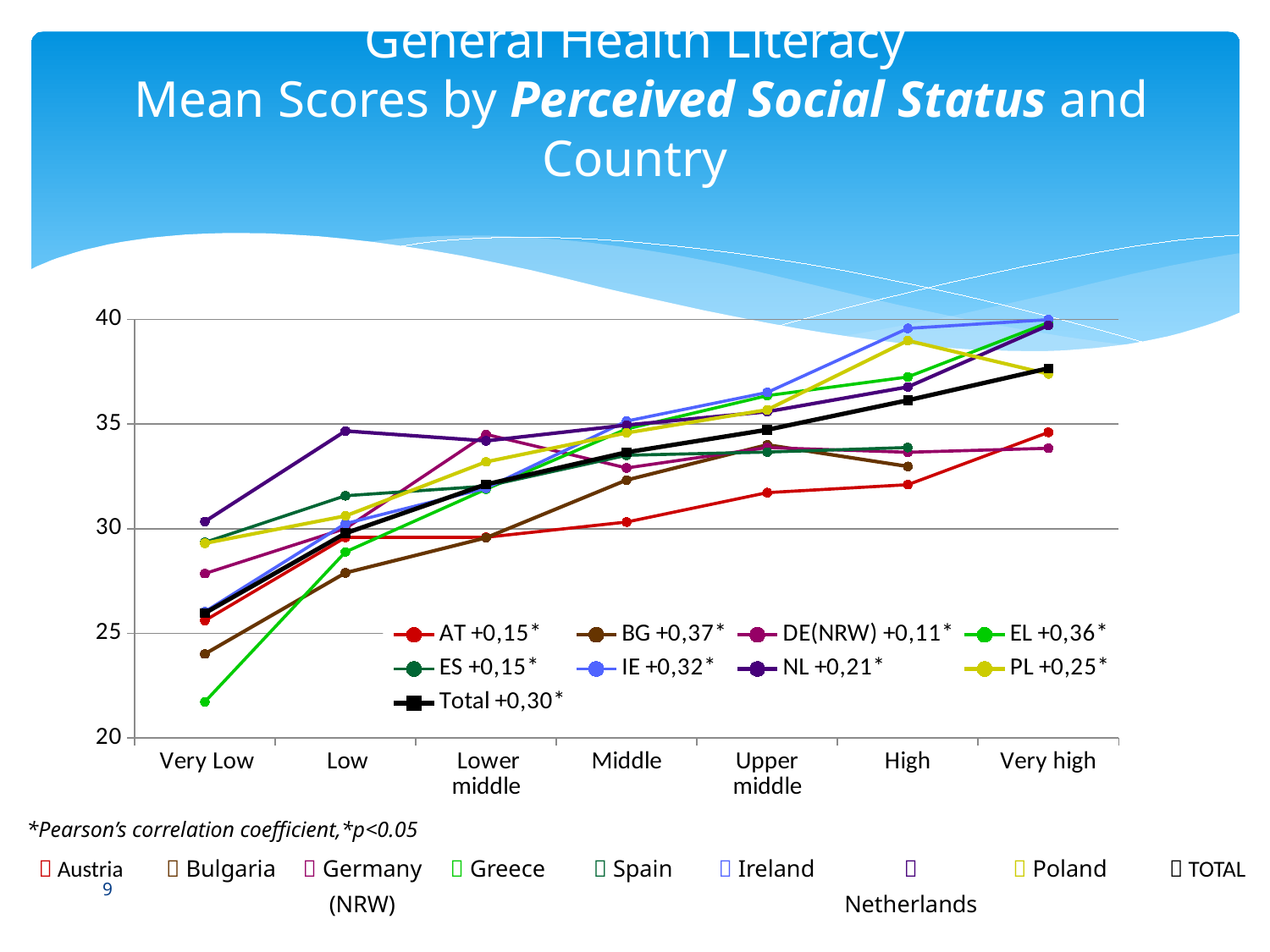
How many perceived social status categories are shown on the x axis? 7 Is the EL value at Very Low perceived social status greater or less than 25? less What kind of chart is shown on the slide? line chart At Very high perceived social status, which is larger, the Total value or the AT value? Total What Pearson's correlation coefficient is shown in the legend for BG? +0,37 Which series has the lowest mean score at Very Low perceived social status? EL Is the Total value at Very Low perceived social status greater or less than 25? greater Does the Total line rise or fall from Very Low to Very high perceived social status? rise How many series does the legend list? 9 Which series has the lowest mean score at Middle perceived social status? AT Which series has the highest mean score at Low perceived social status? NL Is the IE value at High perceived social status greater or less than 35? greater